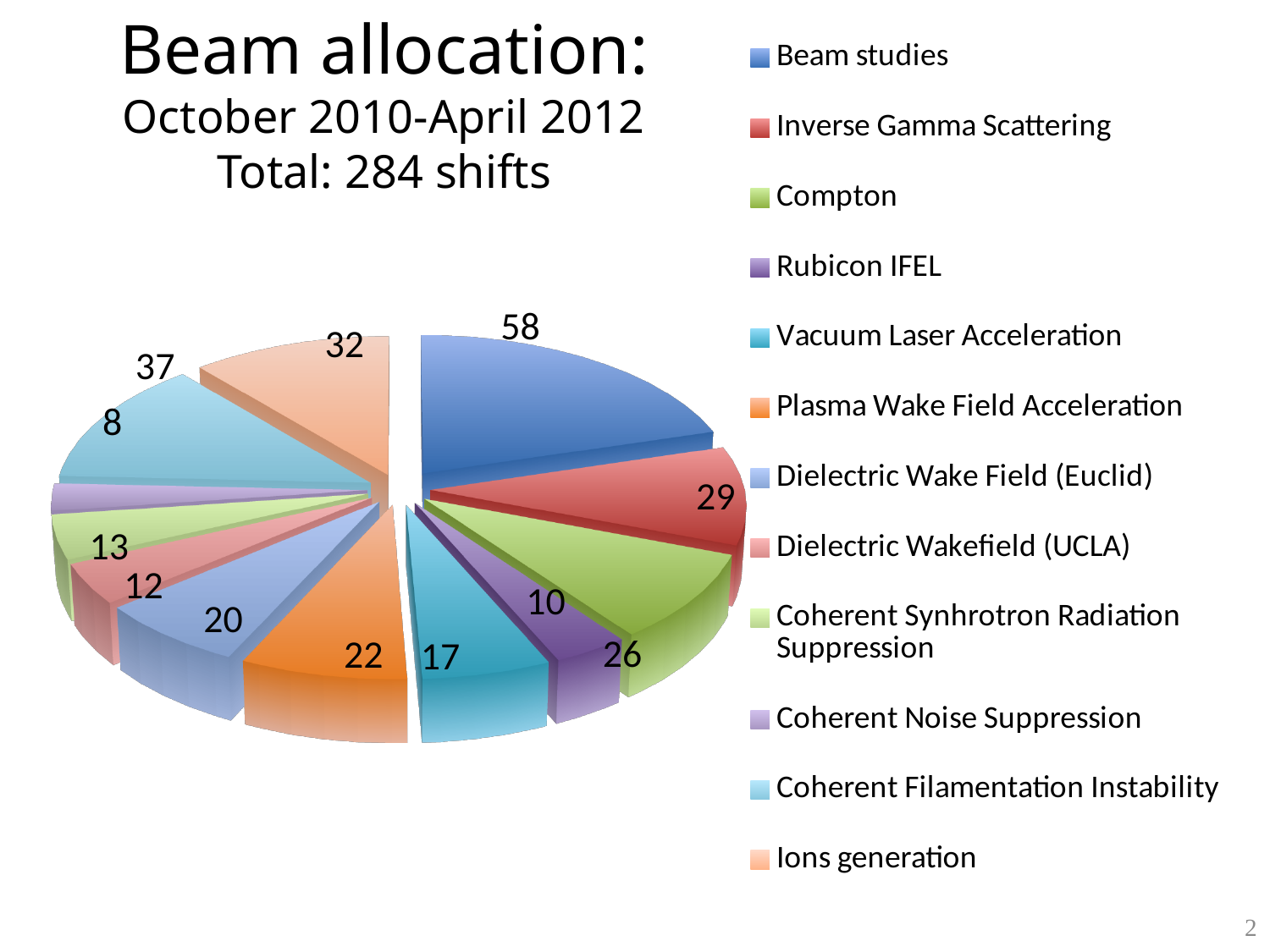
What time period does the chart title say the beam allocation covers? October 2010-April 2012 How many categories are shown in the pie chart? 12 What is the total number of shifts shown in the chart? 284 shifts What is the difference in shifts between Beam studies and Inverse Gamma Scattering? 29 How many shifts were allocated to Plasma Wake Field Acceleration? 22 What type of chart is shown on the slide? Pie chart Which category received the fewest shifts? Coherent Noise Suppression How many shifts were allocated to Beam studies? 58 Which category received the most shifts? Beam studies How many shifts were allocated to Rubicon IFEL? 10 How many shifts were allocated to Coherent Filamentation Instability? 37 Which received more shifts, Compton or Ions generation? Ions generation